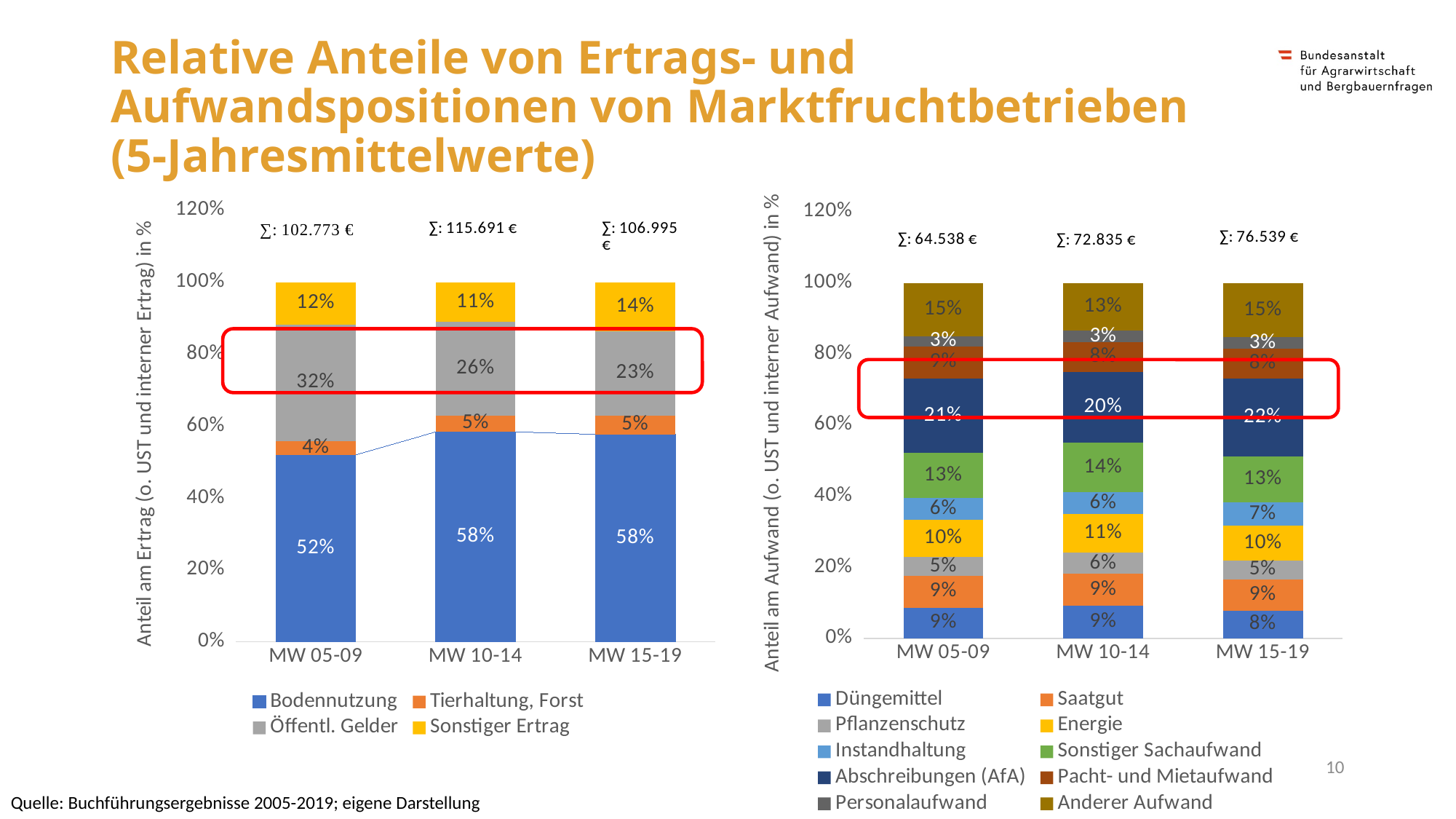
In the left chart (Anteil am Ertrag), does the share of Öffentl. Gelder rise or fall from MW 05-09 to MW 15-19? fall What type of chart is the right chart (Anteil am Aufwand)? Stacked bar chart In the left chart (Anteil am Ertrag), in which period is the share of Öffentl. Gelder highest? MW 05-09 In the right chart (Anteil am Aufwand), what is the value for Energie in MW 10-14? 11% In the left chart (Anteil am Ertrag), what is the difference between the Öffentl. Gelder share in MW 05-09 and in MW 15-19? 9 percentage points In the left chart (Anteil am Ertrag), what is the value for Bodennutzung in MW 05-09? 52% How many series does the legend of the left chart (Anteil am Ertrag) list? 4 In the right chart (Anteil am Aufwand), what is the value for Abschreibungen (AfA) in MW 15-19? 22% In the left chart (Anteil am Ertrag), what is the value for Öffentl. Gelder in MW 15-19? 23% In the left chart (Anteil am Ertrag), what is the value for Sonstiger Ertrag in MW 10-14? 11% In the right chart (Anteil am Aufwand), which is larger in MW 05-09: Sonstiger Sachaufwand or Anderer Aufwand? Anderer Aufwand How many series does the legend of the right chart (Anteil am Aufwand) list? 10